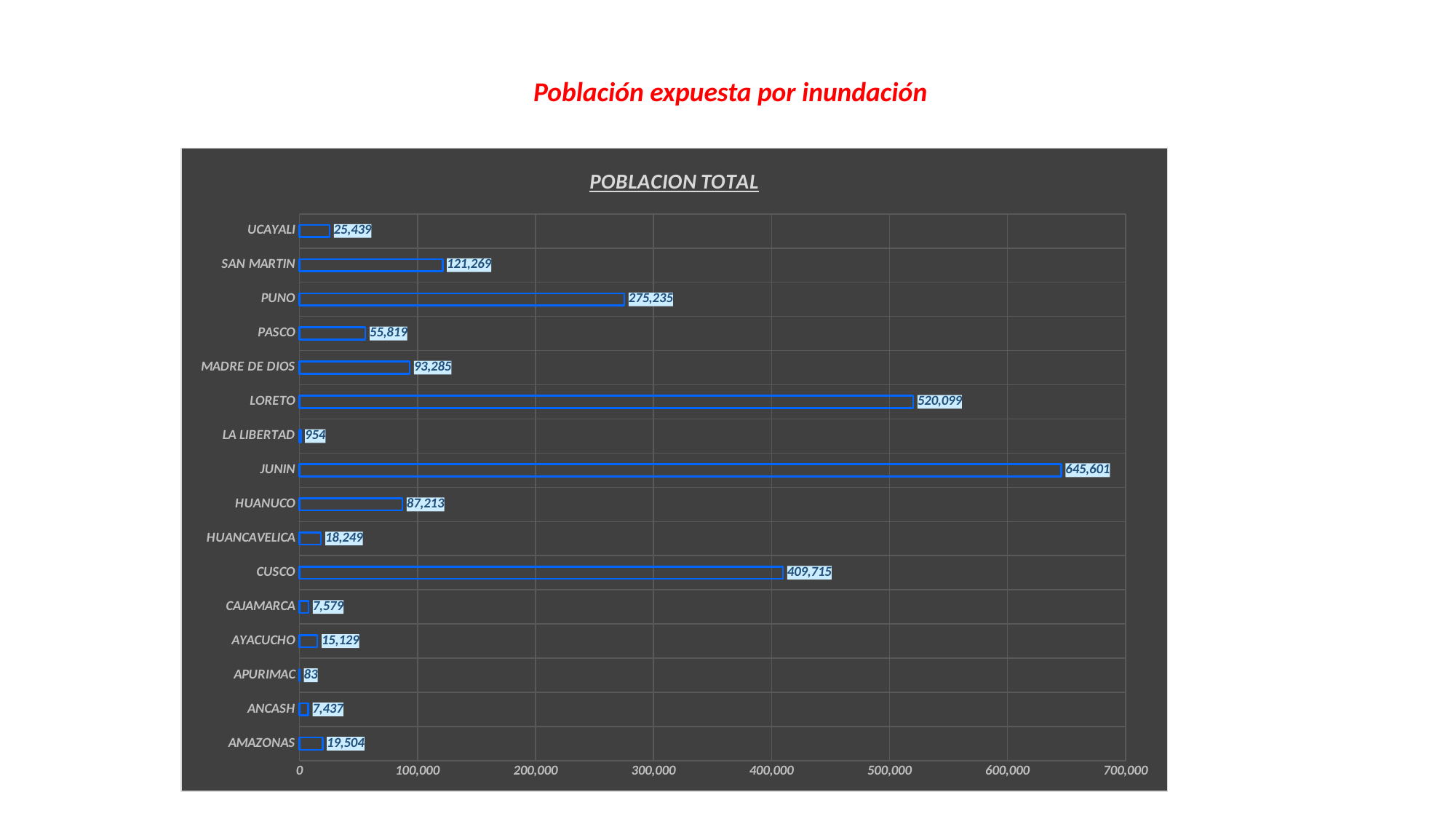
What is the value for LA LIBERTAD? 954 What is the value for JUNIN? 645,601 How many categories are shown in the chart? 16 What is the difference between the values for JUNIN and LORETO? 125,502 Which category has the lowest value? APURIMAC What is the difference between the values for CUSCO and PUNO? 134,480 What kind of chart is shown on the slide? bar chart What is the title of the chart? POBLACION TOTAL Which is larger, the value for PASCO or the value for HUANUCO? HUANUCO Which category has the highest value? JUNIN Is the value for LORETO greater or less than 500,000? greater What is the value for MADRE DE DIOS? 93,285